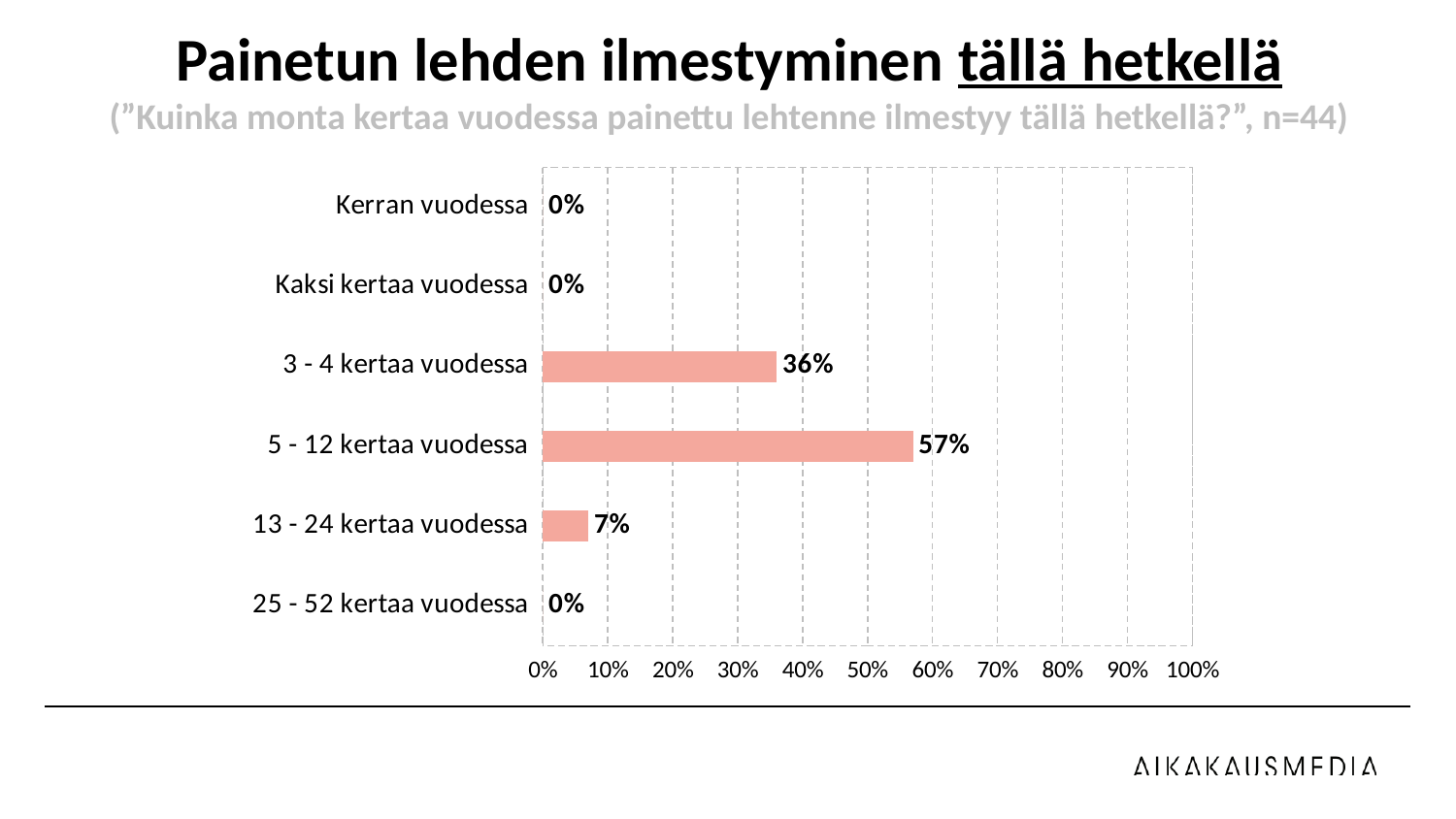
Which category has the highest value? 5 - 12 kertaa vuodessa What is the difference between the values for "3 - 4 kertaa vuodessa" and "13 - 24 kertaa vuodessa"? 29% Is the value for "5 - 12 kertaa vuodessa" greater or less than 50%? greater Which is larger, the value for "3 - 4 kertaa vuodessa" or "13 - 24 kertaa vuodessa"? 3 - 4 kertaa vuodessa What is the value for "Kerran vuodessa"? 0% How many categories are shown in the chart? 6 What is the difference between the values for "5 - 12 kertaa vuodessa" and "3 - 4 kertaa vuodessa"? 21% What kind of chart is shown on the slide? bar chart What is the value for "13 - 24 kertaa vuodessa"? 7% What is the value for "5 - 12 kertaa vuodessa"? 57% What is the value for "3 - 4 kertaa vuodessa"? 36% How many categories have a value of 0%? 3